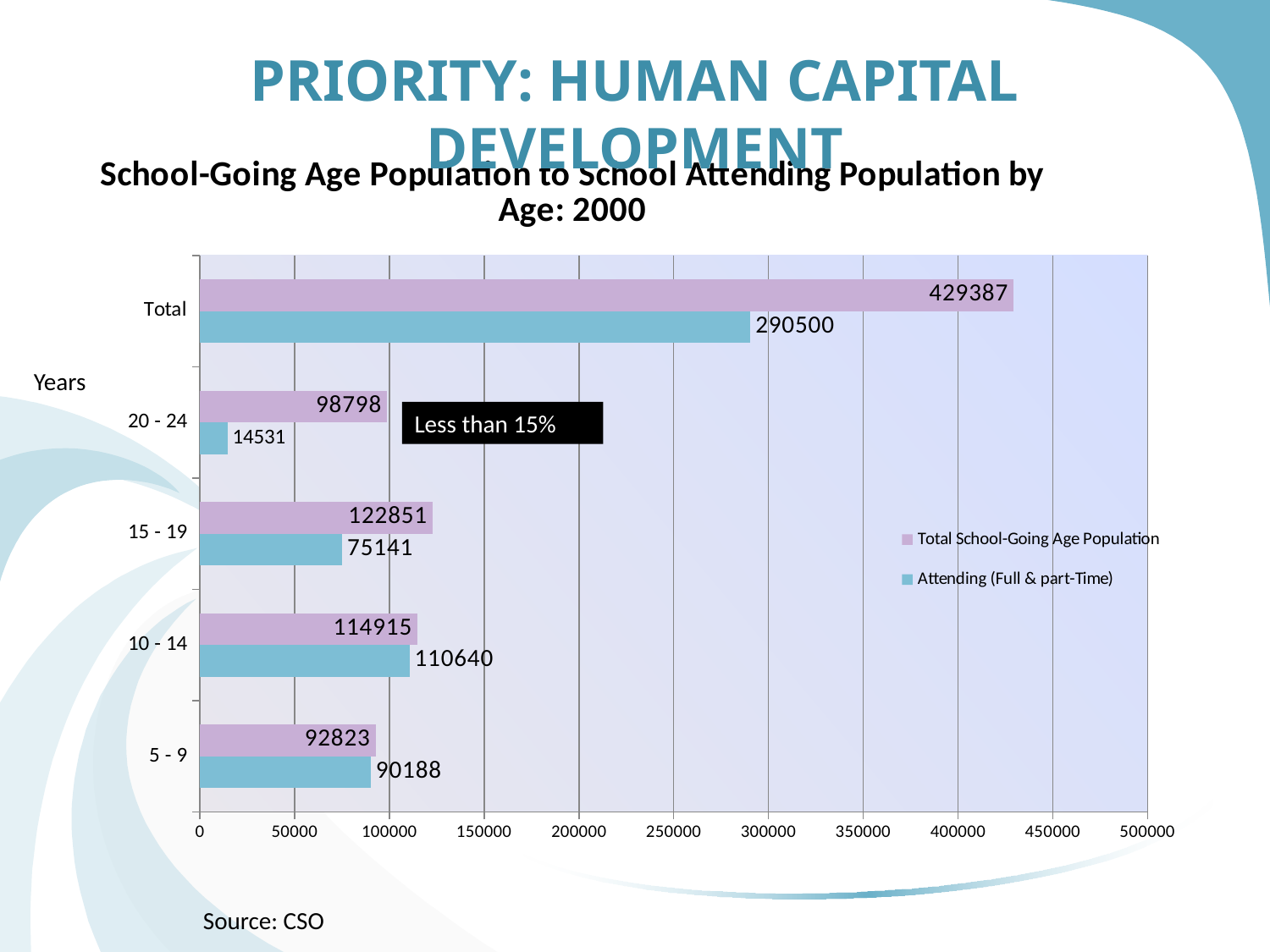
Is the Total School-Going Age Population for the Total category greater or less than 400000? greater What is the Total School-Going Age Population for the 20 - 24 age group? 98798 What is the Attending (Full & part-Time) value for the Total category? 290500 What is the difference between the Total School-Going Age Population and the Attending (Full & part-Time) value for the 5 - 9 age group? 2635 How many series does the chart legend list? 2 How many categories are shown on the vertical axis of the chart? 5 What is the Attending (Full & part-Time) value for the 15 - 19 age group? 75141 What kind of chart is shown on the slide? Bar chart Excluding the Total category, which age group has the lowest Attending (Full & part-Time) value? 20 - 24 Excluding the Total category, which age group has the highest Total School-Going Age Population? 15 - 19 Which is larger: the Attending (Full & part-Time) value for 10 - 14 or for 15 - 19? 10 - 14 What is the difference between the Total School-Going Age Population and the Attending (Full & part-Time) value for the 20 - 24 age group? 84267